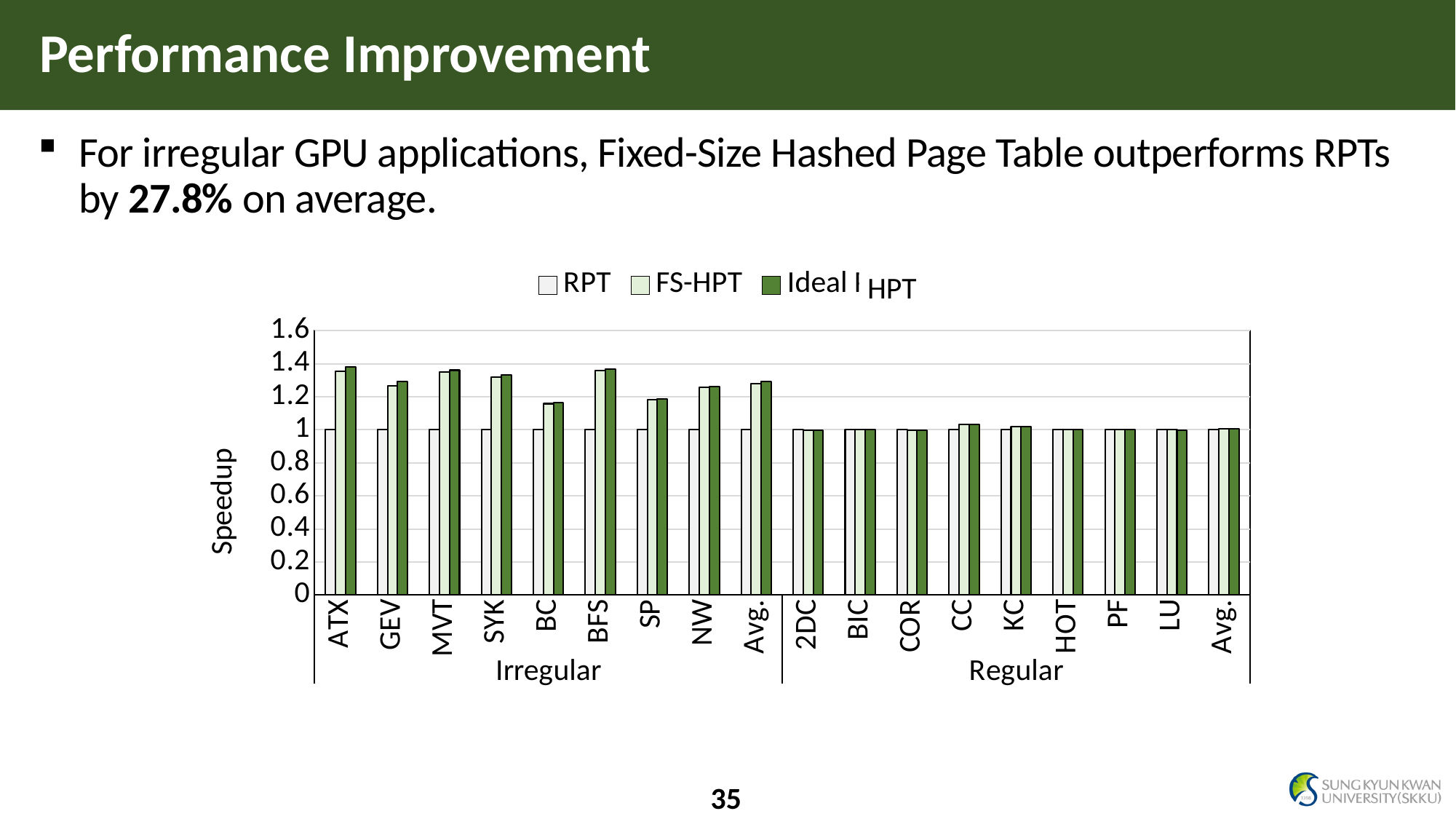
What is the RPT speedup value for ATX? 1 What are the two groups into which the x-axis categories are divided? Irregular and Regular What kind of chart is shown on the slide? bar chart Which is larger, the Ideal HPT value for MVT or the Ideal HPT value for 2DC? MVT Is the Ideal HPT value for BFS greater or less than 1.2? greater Which is larger, the FS-HPT value for GEV or the FS-HPT value for BC? GEV How many series does the chart legend list? 3 How many application categories are plotted along the x axis of the chart (including both Avg. entries)? 18 What is the label of the y axis of the chart? Speedup Is the FS-HPT value for ATX greater or less than 1.2? greater What is the RPT speedup value for BFS? 1 Is the FS-HPT value for BC greater or less than 1.2? less